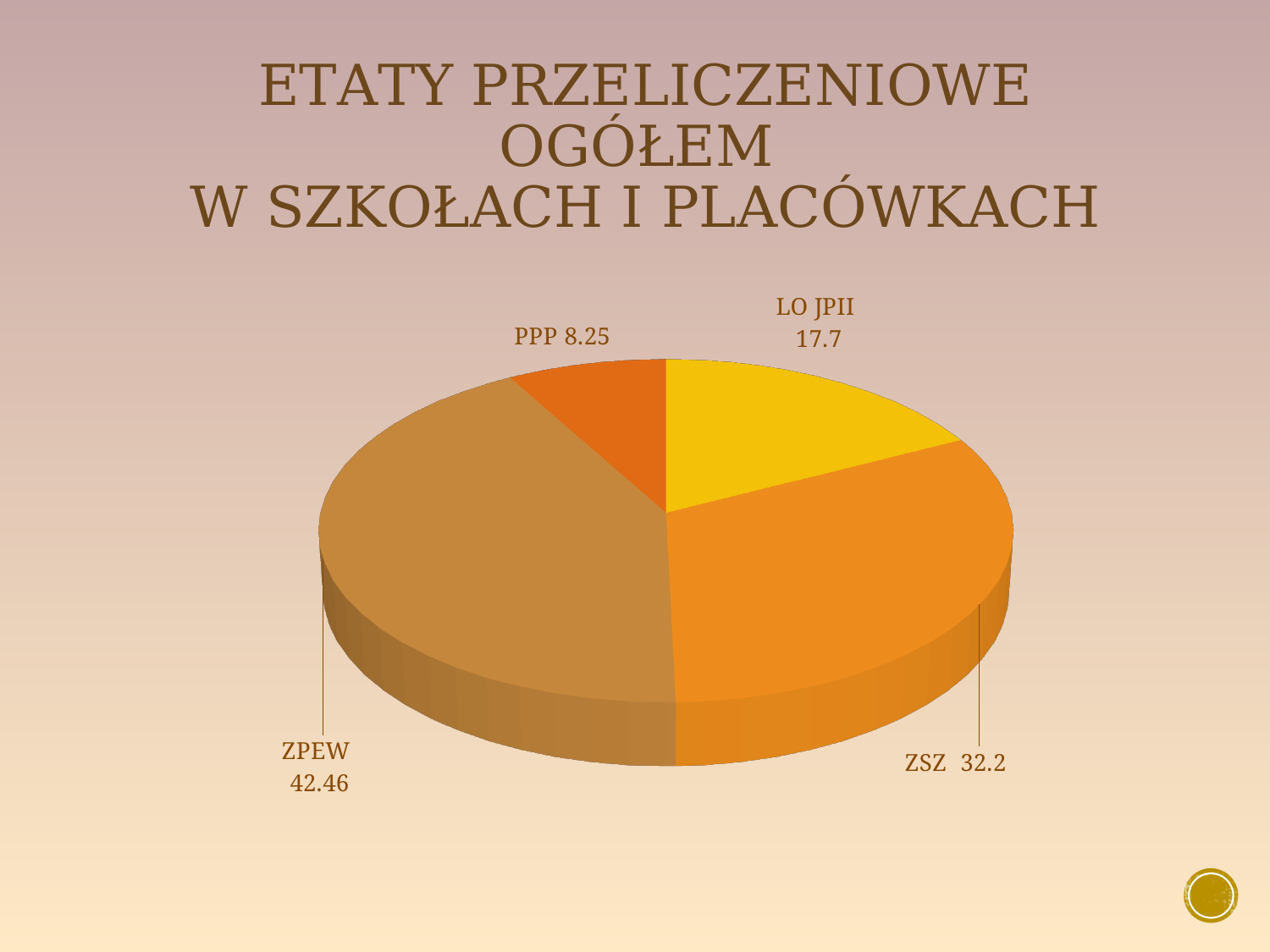
How many categories are shown in the pie chart? 4 Which is larger, the value for LO JPII or the value for PPP? LO JPII What is the title of the chart on the slide? ETATY PRZELICZENIOWE OGÓŁEM W SZKOŁACH I PLACÓWKACH What is the difference between the values for ZPEW and ZSZ? 10.26 What kind of chart is shown on the slide? Pie chart What is the value for LO JPII in the pie chart? 17.7 What is the value for PPP in the pie chart? 8.25 Which category has the smallest slice in the pie chart? PPP What is the value for ZSZ in the pie chart? 32.2 Which category has the largest slice in the pie chart? ZPEW What is the difference between the values for ZSZ and LO JPII? 14.5 What is the value for ZPEW in the pie chart? 42.46